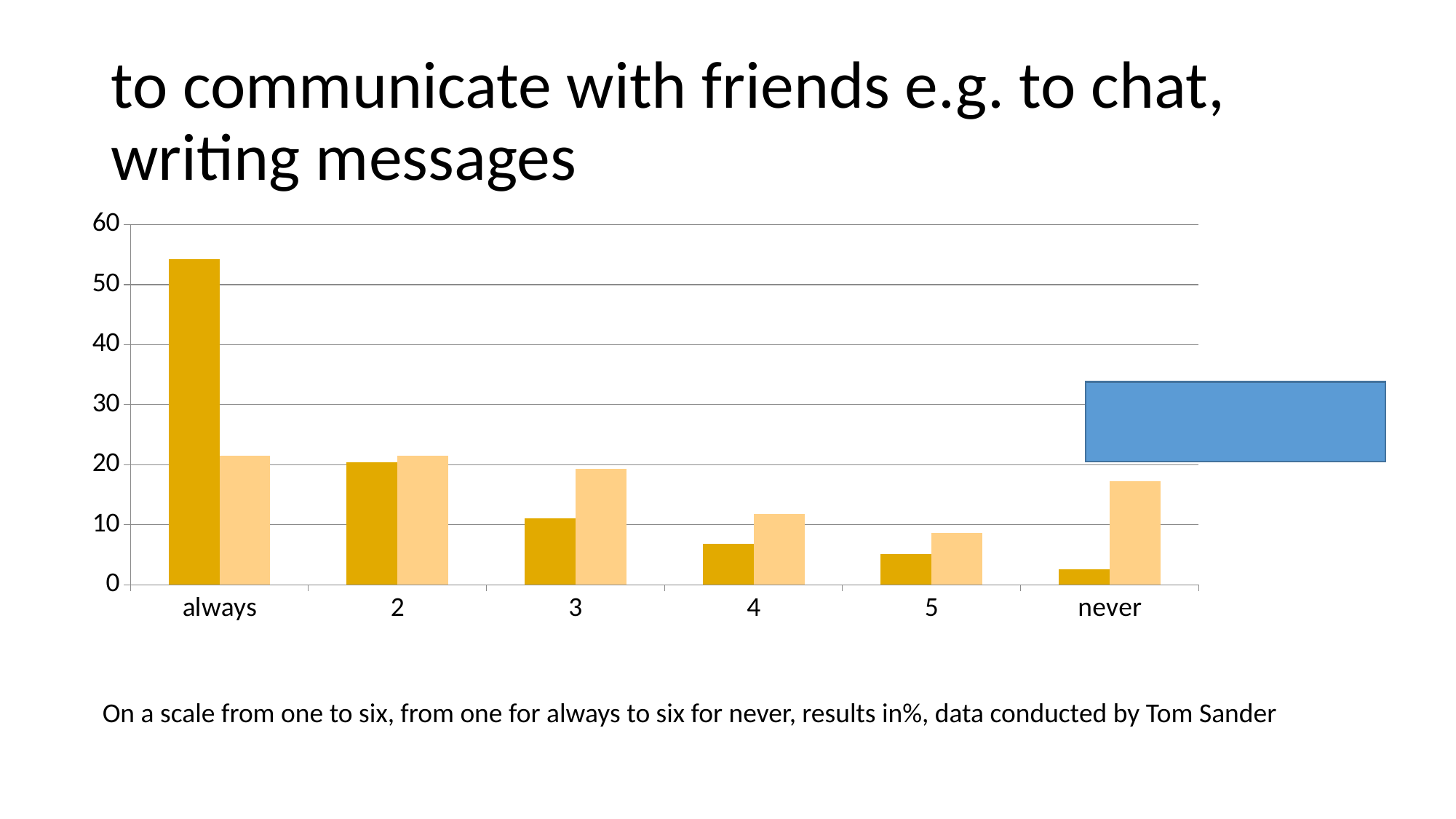
Which category has the lowest light orange bar? 5 Is the dark orange bar for 'always' greater or less than 50? greater Which category has the highest dark orange bar? always Is the dark orange bar for 'never' greater or less than 10? less Which category has the lowest dark orange bar? never How many categories are shown on the x axis? 6 Do the dark orange bars rise or fall from 'always' to 'never' along the x axis? fall What kind of chart is shown on the slide? bar chart Is the dark orange bar for '4' greater or less than 10? less For the category 'never', which bar is taller, the dark orange or the light orange one? light orange For the category 'always', which bar is taller, the dark orange or the light orange one? dark orange